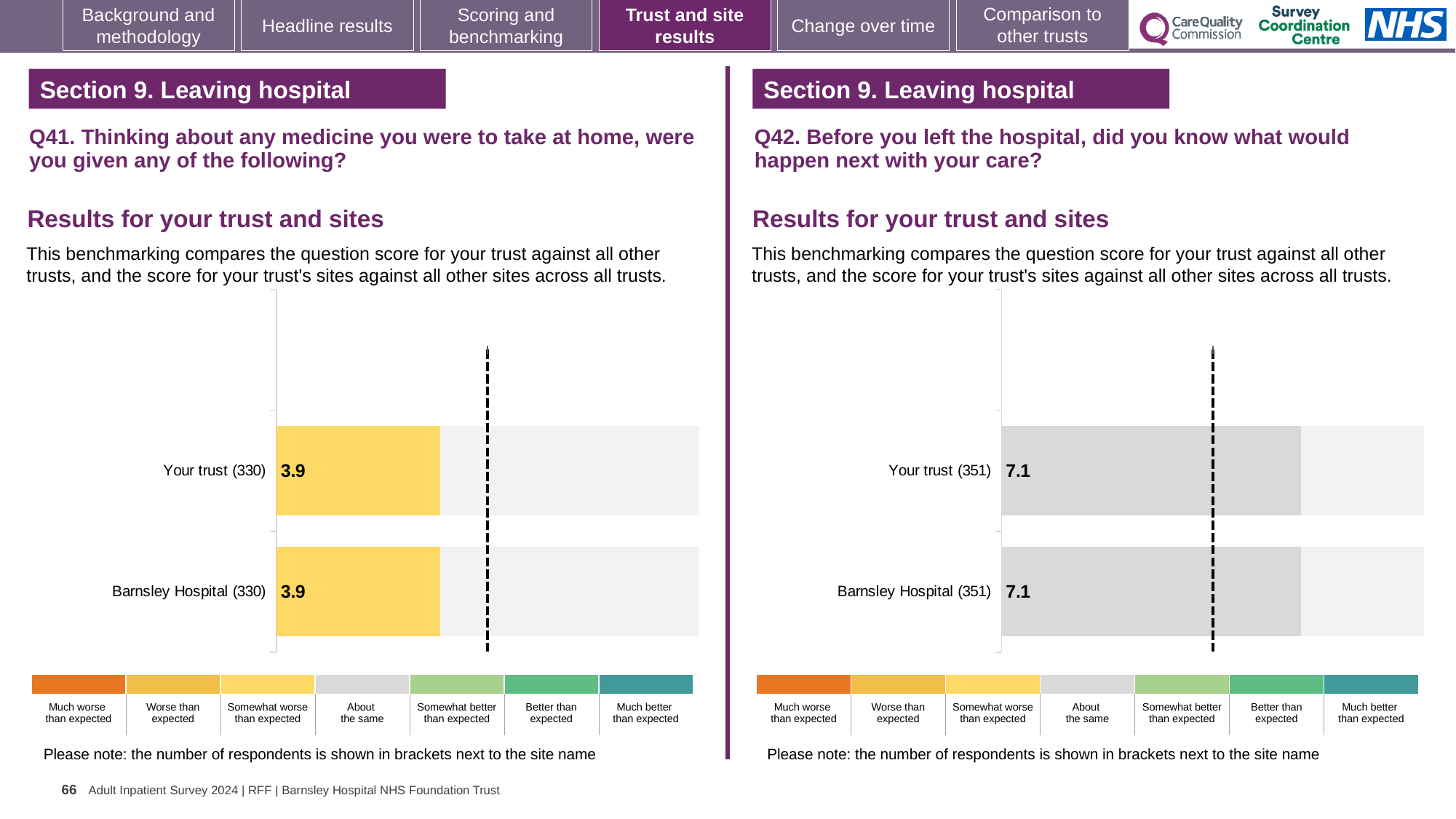
On the Q41 chart (left), what is the difference between the score for Your trust and the score for Barnsley Hospital? 0.0 On the Q42 chart (right), what is the difference between the score for Your trust and the score for Barnsley Hospital? 0.0 On the Q42 chart (right), how many bars are plotted? 2 On the Q41 chart (left), how many respondents are shown in brackets next to Barnsley Hospital? 330 What type of chart is used on the Q41 chart (left)? Bar chart On the Q41 chart (left), what is the score for Barnsley Hospital (330)? 3.9 On the Q41 chart (left), which benchmark category does the yellow colour of the bars correspond to in the key? Somewhat worse than expected On the Q41 chart (left), what is the score for Your trust (330)? 3.9 On the Q42 chart (right), what is the score for Your trust (351)? 7.1 On the Q42 chart (right), what is the score for Barnsley Hospital (351)? 7.1 On the Q41 chart (left), how many bars are plotted? 2 On the Q42 chart (right), which benchmark category does the grey colour of the bars correspond to in the key? About the same